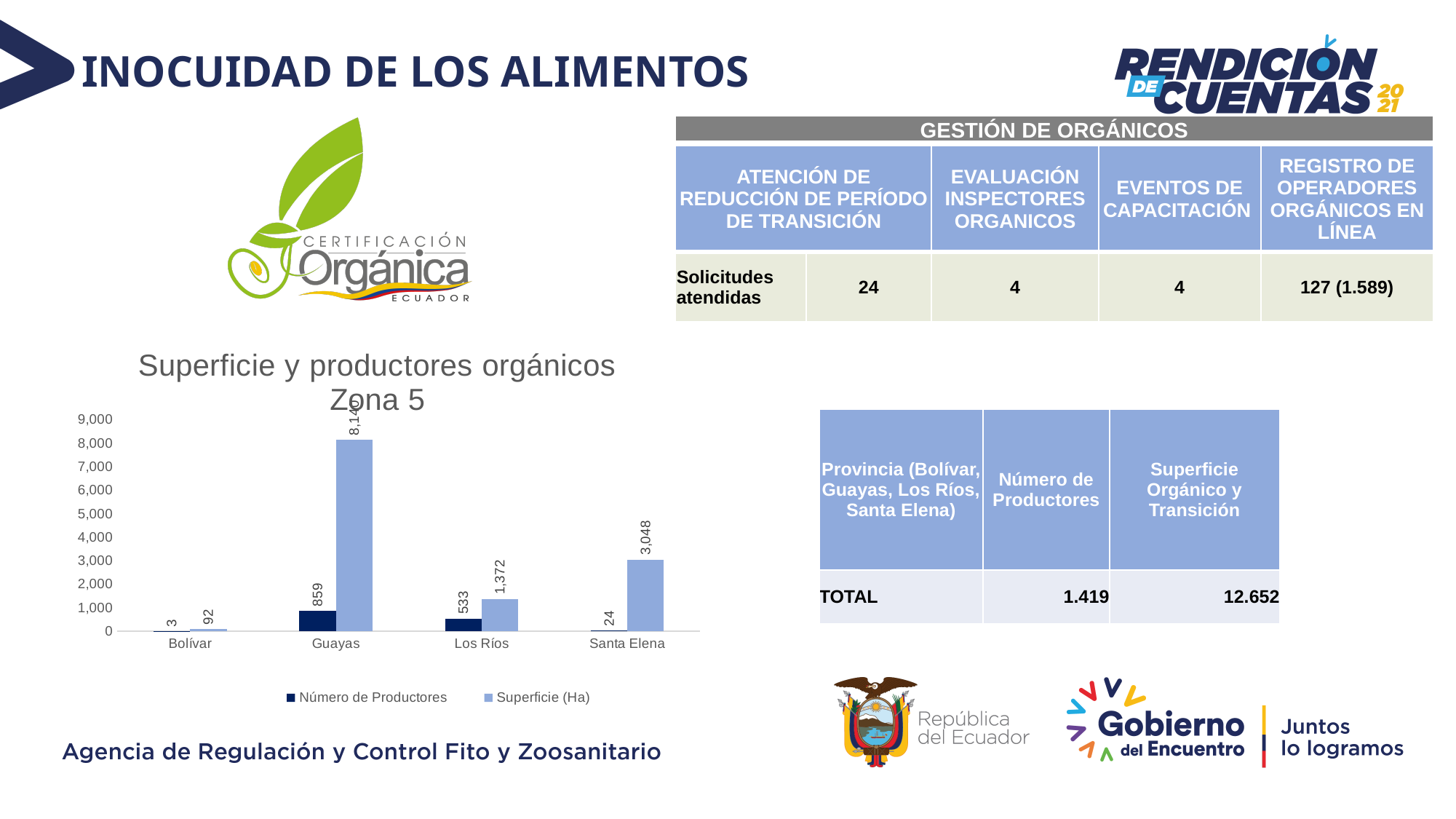
Is the Superficie (Ha) value for Guayas greater or less than 8,000? greater Which province has the lowest Número de Productores? Bolívar What is the Número de Productores value for Bolívar? 3 What is the difference between the Número de Productores for Guayas and Los Ríos? 326 What is the Número de Productores value for Guayas? 859 What is the Superficie (Ha) value for Santa Elena? 3,048 What is the Superficie (Ha) value for Los Ríos? 1,372 Which province has the highest Superficie (Ha)? Guayas How many series does the chart legend list? 2 Which is larger: the Superficie (Ha) for Santa Elena or for Los Ríos? Santa Elena How many provinces are shown on the x axis of the chart? 4 What type of chart is used to show Superficie y productores orgánicos Zona 5? bar chart